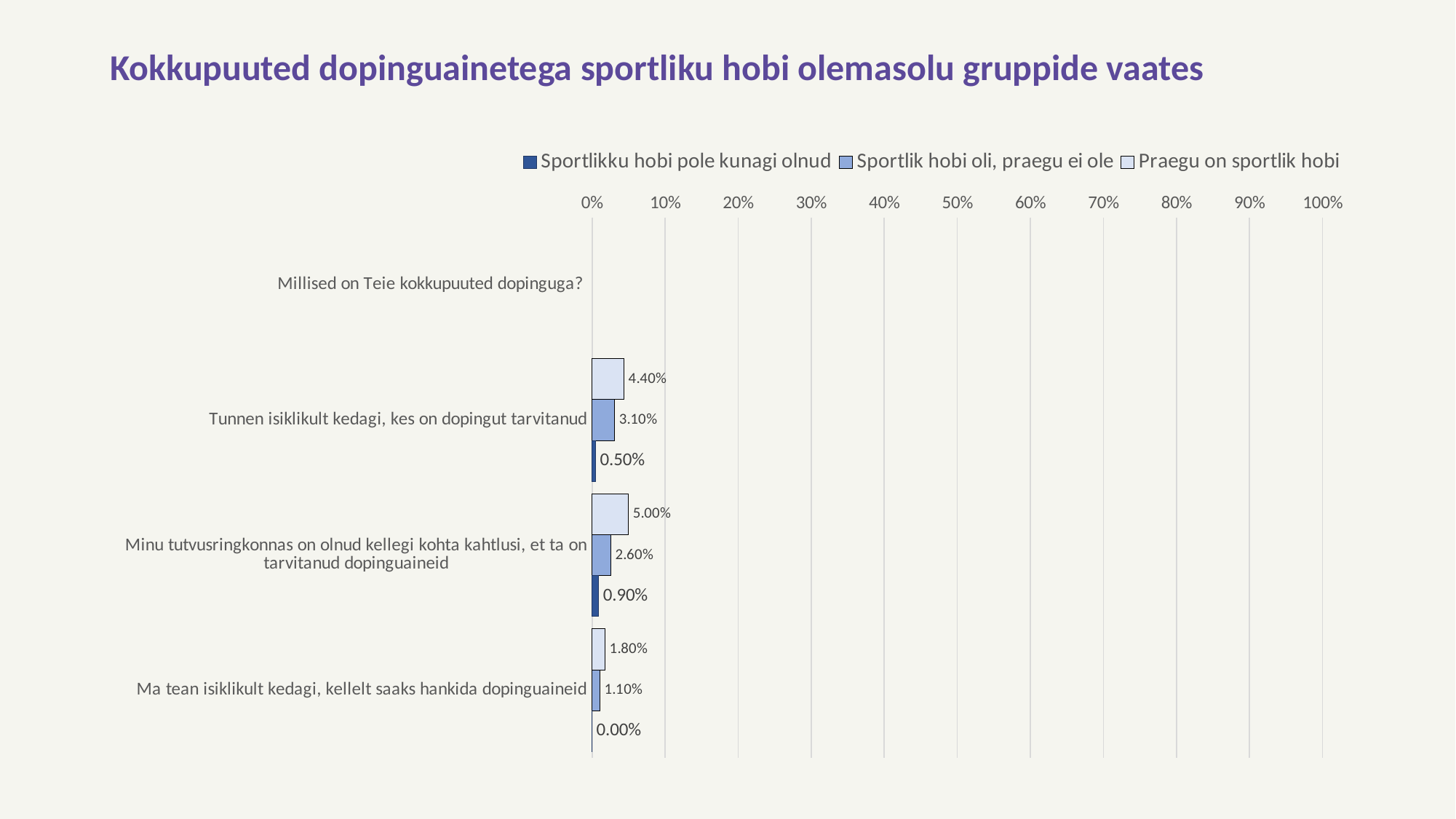
In the category 'Minu tutvusringkonnas on olnud kellegi kohta kahtlusi, et ta on tarvitanud dopinguaineid', which series has the larger value: 'Sportlik hobi oli, praegu ei ole' or 'Sportlikku hobi pole kunagi olnud'? Sportlik hobi oli, praegu ei ole How many series does the legend list? 3 What kind of chart is shown on the slide? bar chart Which category has the highest value for the series 'Praegu on sportlik hobi'? Minu tutvusringkonnas on olnud kellegi kohta kahtlusi, et ta on tarvitanud dopinguaineid What is the value for 'Praegu on sportlik hobi' in the category 'Tunnen isiklikult kedagi, kes on dopingut tarvitanud'? 4.40% What is the difference between the 'Praegu on sportlik hobi' and 'Sportlik hobi oli, praegu ei ole' values in the category 'Tunnen isiklikult kedagi, kes on dopingut tarvitanud'? 1.30% Which category has the lowest value for the series 'Sportlik hobi oli, praegu ei ole'? Ma tean isiklikult kedagi, kellelt saaks hankida dopinguaineid What is the value for 'Sportlikku hobi pole kunagi olnud' in the category 'Ma tean isiklikult kedagi, kellelt saaks hankida dopinguaineid'? 0.00% Is the value for 'Praegu on sportlik hobi' in the category 'Minu tutvusringkonnas on olnud kellegi kohta kahtlusi, et ta on tarvitanud dopinguaineid' greater or less than 10%? less What is the value for 'Sportlikku hobi pole kunagi olnud' in the category 'Minu tutvusringkonnas on olnud kellegi kohta kahtlusi, et ta on tarvitanud dopinguaineid'? 0.90% What is the title of the chart? Kokkupuuted dopinguainetega sportliku hobi olemasolu gruppide vaates What is the value for 'Sportlik hobi oli, praegu ei ole' in the category 'Ma tean isiklikult kedagi, kellelt saaks hankida dopinguaineid'? 1.10%